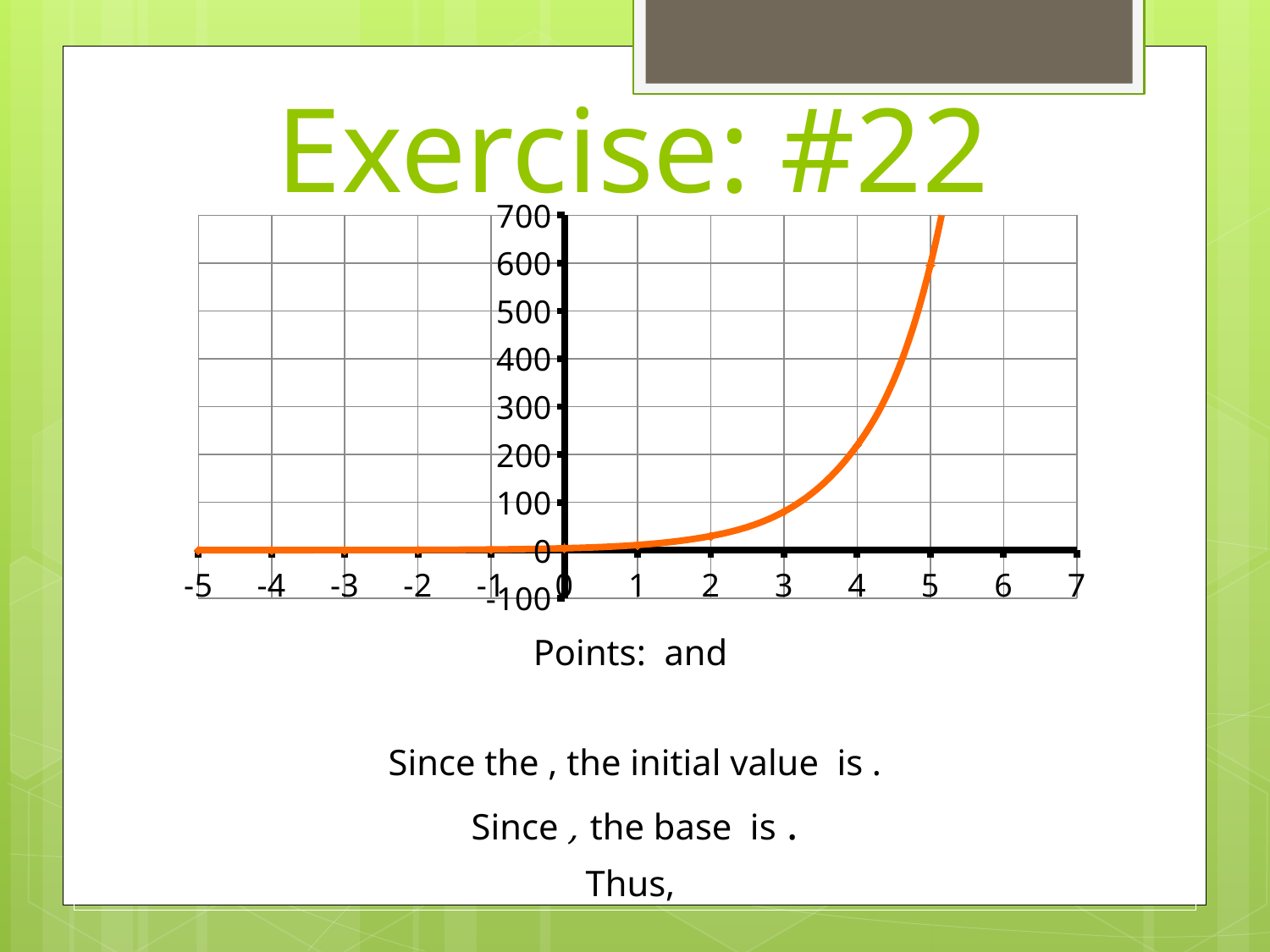
How many curves are plotted on the chart? 1 Is the value of the curve at x = 2 greater or less than 100? less What is the highest value labelled on the vertical axis? 700 How many tick labels are shown on the horizontal axis? 13 Does the plotted curve rise or fall as x increases from left to right? rise Is the value of the curve at x = 5 greater or less than 500? greater What kind of chart is shown on the slide? line chart Is the value of the curve at x = -3 greater or less than 100? less What is the lowest value labelled on the horizontal axis? -5